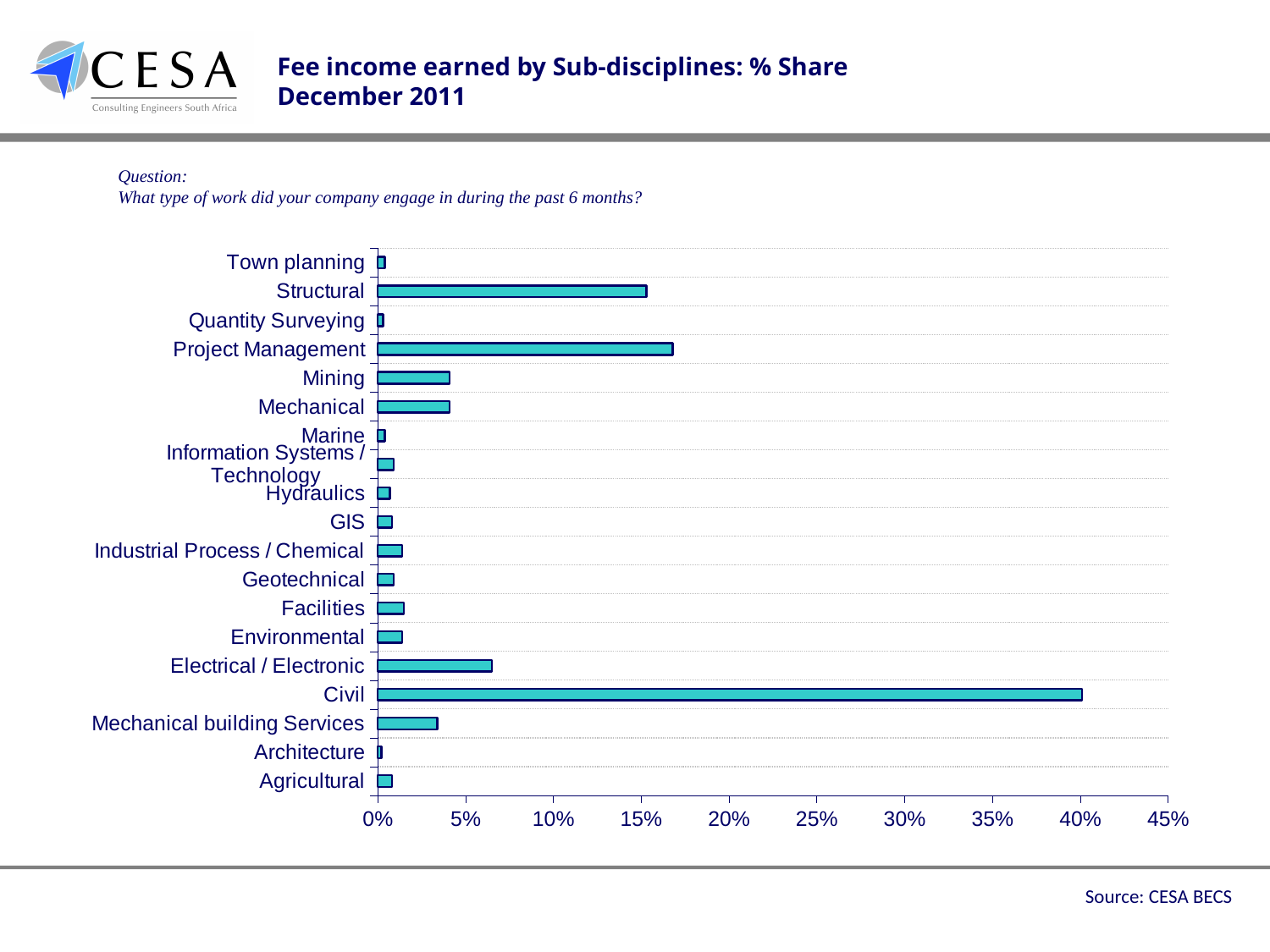
Is the value for Structural greater or less than 10%? greater What kind of chart is shown on the slide? bar chart What is the title of the chart on the slide? Fee income earned by Sub-disciplines: % Share December 2011 How many sub-disciplines are plotted on the chart? 19 Which sub-discipline has the lowest fee income share? Architecture Is the value for Civil greater or less than 35%? greater Which is larger, the value for Electrical / Electronic or the value for Mechanical building Services? Electrical / Electronic Which sub-discipline has the highest fee income share? Civil Which is larger, the value for Project Management or the value for Structural? Project Management Is the value for Electrical / Electronic greater or less than 5%? greater